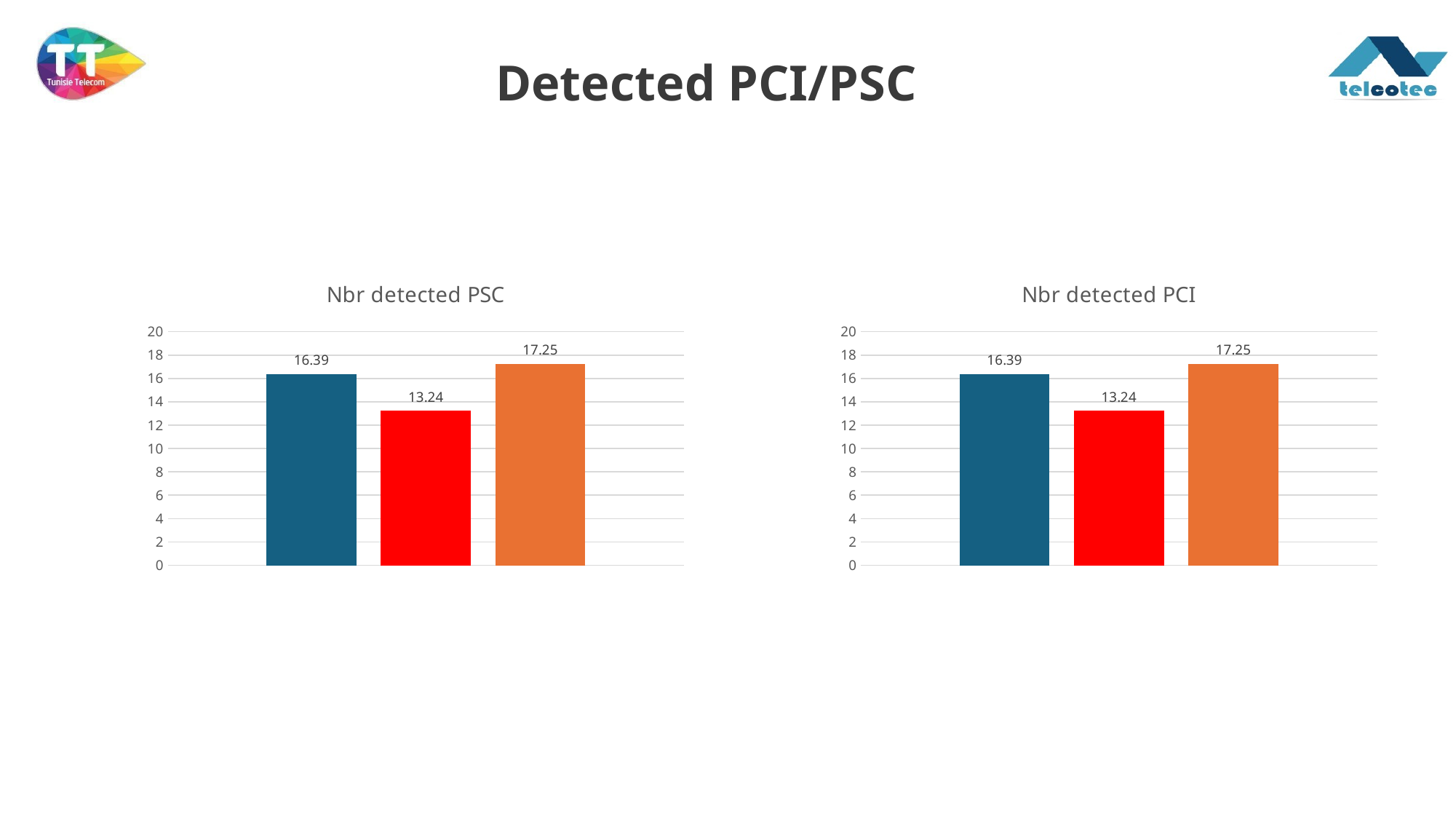
How many bars are plotted in the 'Nbr detected PCI' chart? 3 In the 'Nbr detected PSC' chart, what is the value of the red bar? 13.24 In the 'Nbr detected PSC' chart, what is the value of the blue bar? 16.39 In the 'Nbr detected PCI' chart, which is larger, the blue bar or the orange bar? The orange bar In the 'Nbr detected PSC' chart, which bar has the lowest value? The red bar (13.24) In the 'Nbr detected PCI' chart, which bar has the highest value? The orange bar (17.25) In the 'Nbr detected PCI' chart, what is the value of the orange bar? 17.25 In the 'Nbr detected PCI' chart, what is the difference between the blue bar and the red bar? 3.15 What type of chart is the 'Nbr detected PSC' chart? Bar chart In the 'Nbr detected PSC' chart, is the value of the red bar greater or less than 14? less What is the title of the chart on the right side of the slide? Nbr detected PCI In the 'Nbr detected PSC' chart, what is the difference between the orange bar and the red bar? 4.01